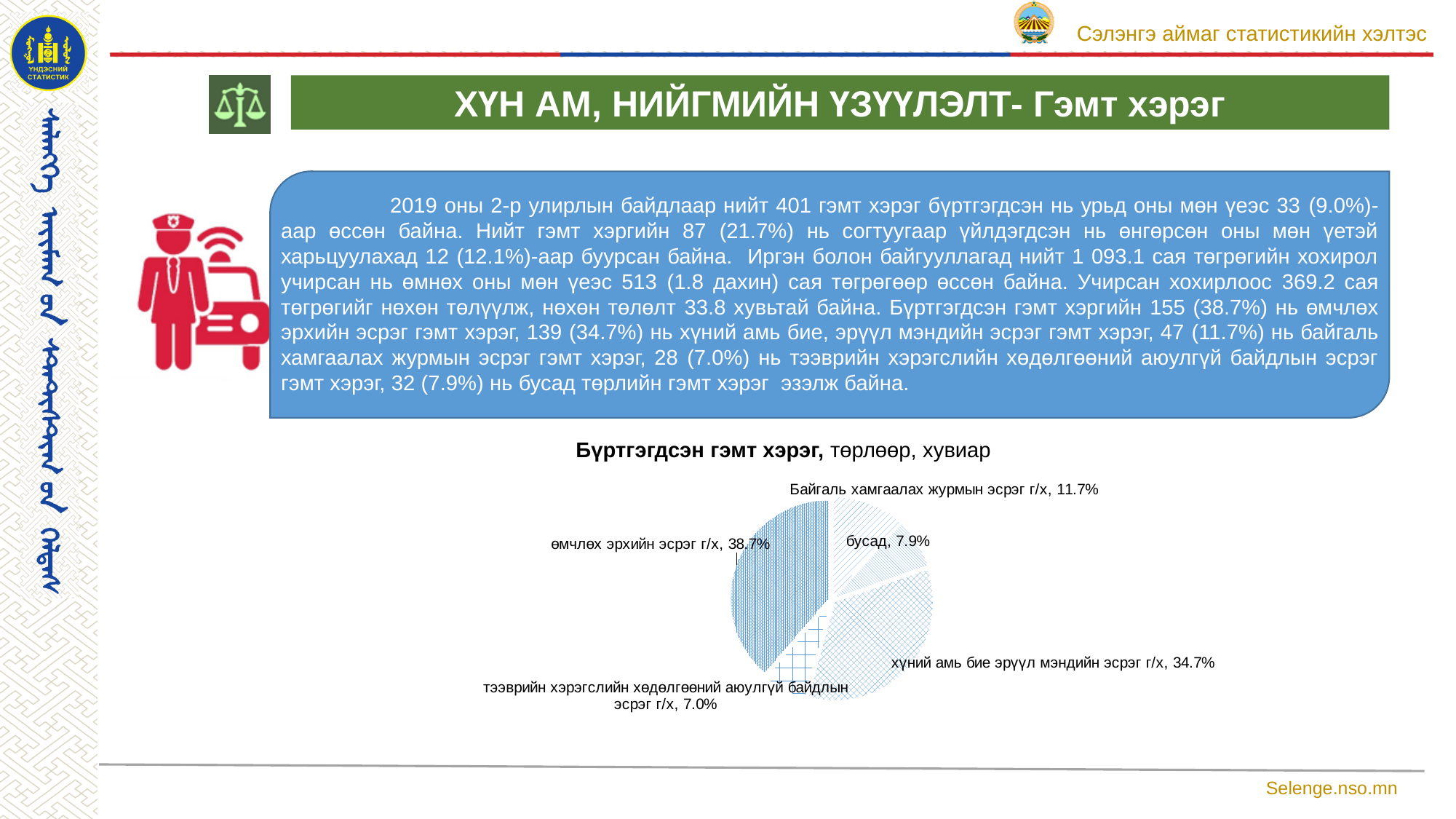
What is the share for "тээврийн хэрэгслийн хөдөлгөөний аюулгүй байдлын эсрэг г/х" in the pie chart? 7.0% What is the share for "өмчлөх эрхийн эсрэг г/х" in the pie chart? 38.7% What is the share for "Байгаль хамгаалах журмын эсрэг г/х" in the pie chart? 11.7% What is the share for "хүний амь бие эрүүл мэндийн эсрэг г/х" in the pie chart? 34.7% Which is larger in the pie chart: "Байгаль хамгаалах журмын эсрэг г/х" or "бусад"? Байгаль хамгаалах журмын эсрэг г/х What is the title of the pie chart? Бүртгэгдсэн гэмт хэрэг, төрлөөр, хувиар How many slices does the pie chart have? 5 What kind of chart is shown on the slide? pie chart What is the share for "бусад" in the pie chart? 7.9% What is the difference in percentage points between "өмчлөх эрхийн эсрэг г/х" and "хүний амь бие эрүүл мэндийн эсрэг г/х"? 4.0% Which category has the largest slice in the pie chart? өмчлөх эрхийн эсрэг г/х Which category has the smallest slice in the pie chart? тээврийн хэрэгслийн хөдөлгөөний аюулгүй байдлын эсрэг г/х